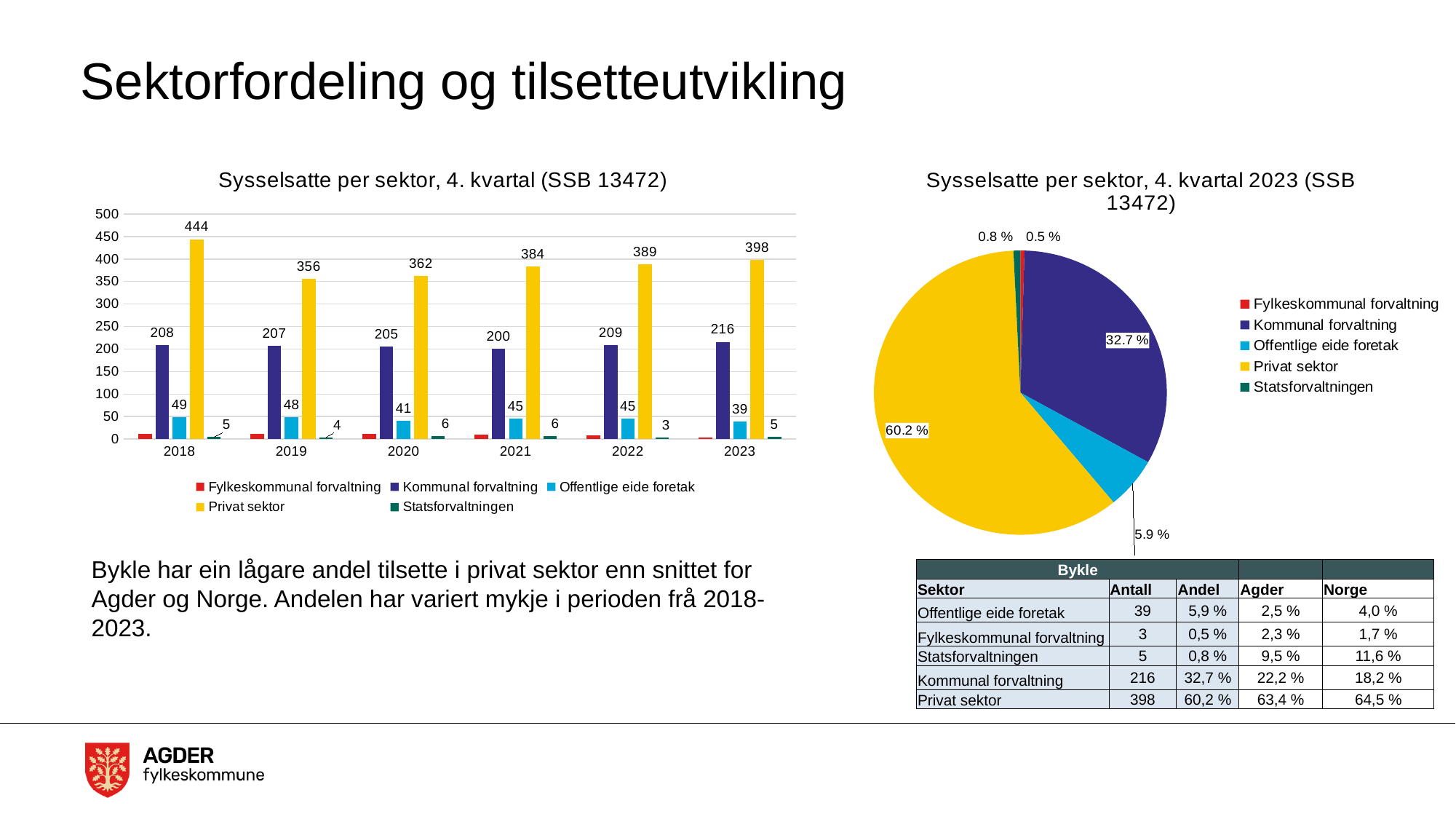
In the bar chart 'Sysselsatte per sektor, 4. kvartal (SSB 13472)', in which year is the Privat sektor value lowest? 2019 In the pie chart 'Sysselsatte per sektor, 4. kvartal 2023 (SSB 13472)', what share does Privat sektor have? 60.2 % In the bar chart 'Sysselsatte per sektor, 4. kvartal (SSB 13472)', how many series does the legend list? 5 In the bar chart 'Sysselsatte per sektor, 4. kvartal (SSB 13472)', what is the value for Offentlige eide foretak in 2020? 41 In the bar chart 'Sysselsatte per sektor, 4. kvartal (SSB 13472)', how many years are shown on the x axis? 6 In the bar chart 'Sysselsatte per sektor, 4. kvartal (SSB 13472)', what is the value for Privat sektor in 2018? 444 In the bar chart 'Sysselsatte per sektor, 4. kvartal (SSB 13472)', which is larger: Offentlige eide foretak in 2018 or in 2023? 2018 What kind of chart is 'Sysselsatte per sektor, 4. kvartal 2023 (SSB 13472)' on the right of the slide? pie chart In the bar chart 'Sysselsatte per sektor, 4. kvartal (SSB 13472)', what is the difference between the Privat sektor values in 2018 and 2019? 88 In the pie chart 'Sysselsatte per sektor, 4. kvartal 2023 (SSB 13472)', which sector has the smallest slice? Fylkeskommunal forvaltning In the bar chart 'Sysselsatte per sektor, 4. kvartal (SSB 13472)', does the Privat sektor value rise or fall from 2019 to 2023? rise In the bar chart 'Sysselsatte per sektor, 4. kvartal (SSB 13472)', what is the value for Kommunal forvaltning in 2023? 216